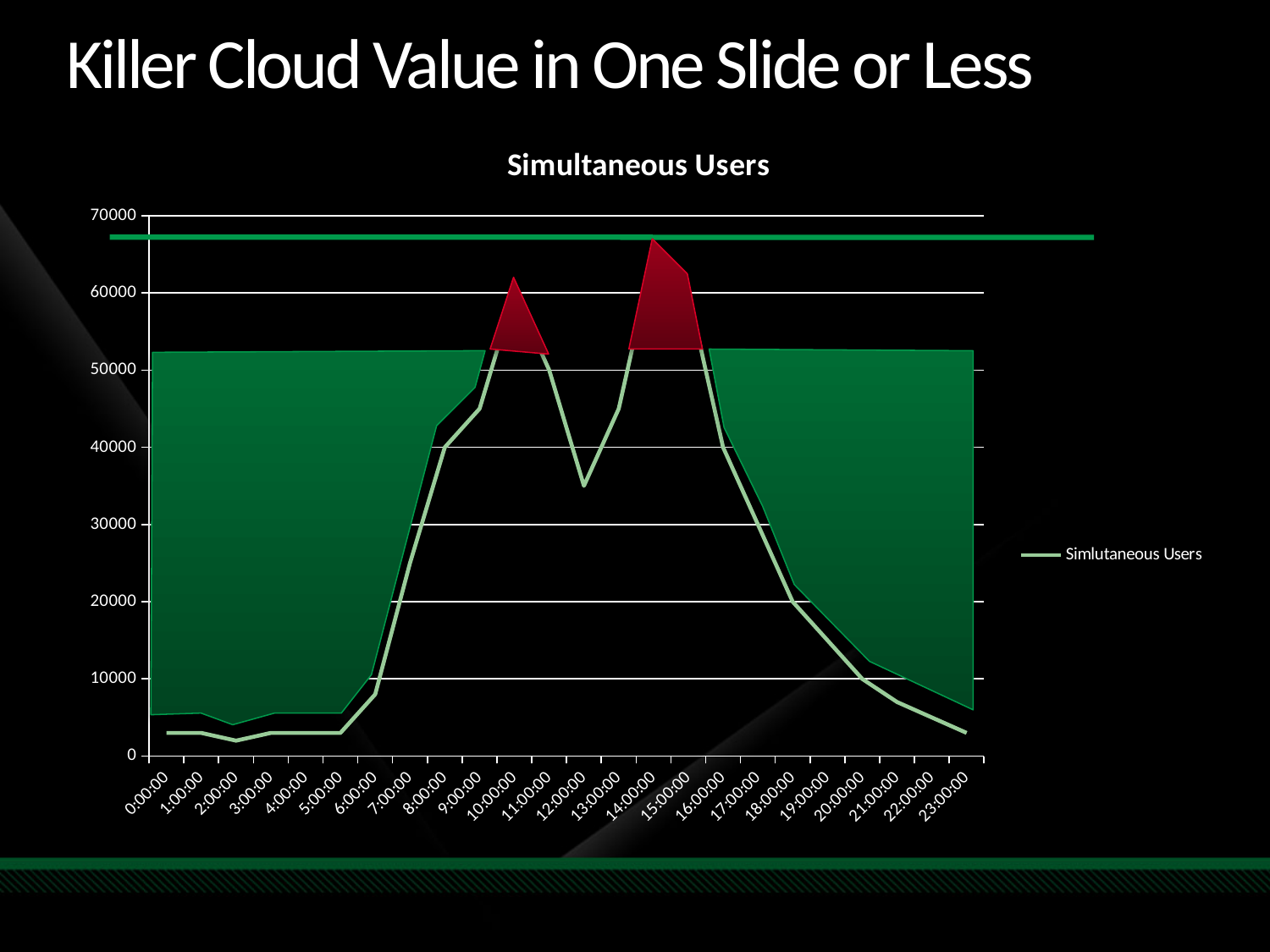
Do the values rise or fall between 5:00:00 and 10:00:00? rise What is the title of the chart? Simultaneous Users What kind of chart is shown on the slide? line chart Is the value at 10:00:00 greater or less than 50000? greater Is the value at 14:00:00 greater or less than 60000? greater Which has more simultaneous users, 8:00:00 or 20:00:00? 8:00:00 Do the values rise or fall between 14:00:00 and 23:00:00? fall At which time does the number of simultaneous users reach its highest point? 14:00:00 How many time points are plotted along the x axis? 24 Is the value at 12:00:00 greater or less than 40000? less How many series does the legend list? 1